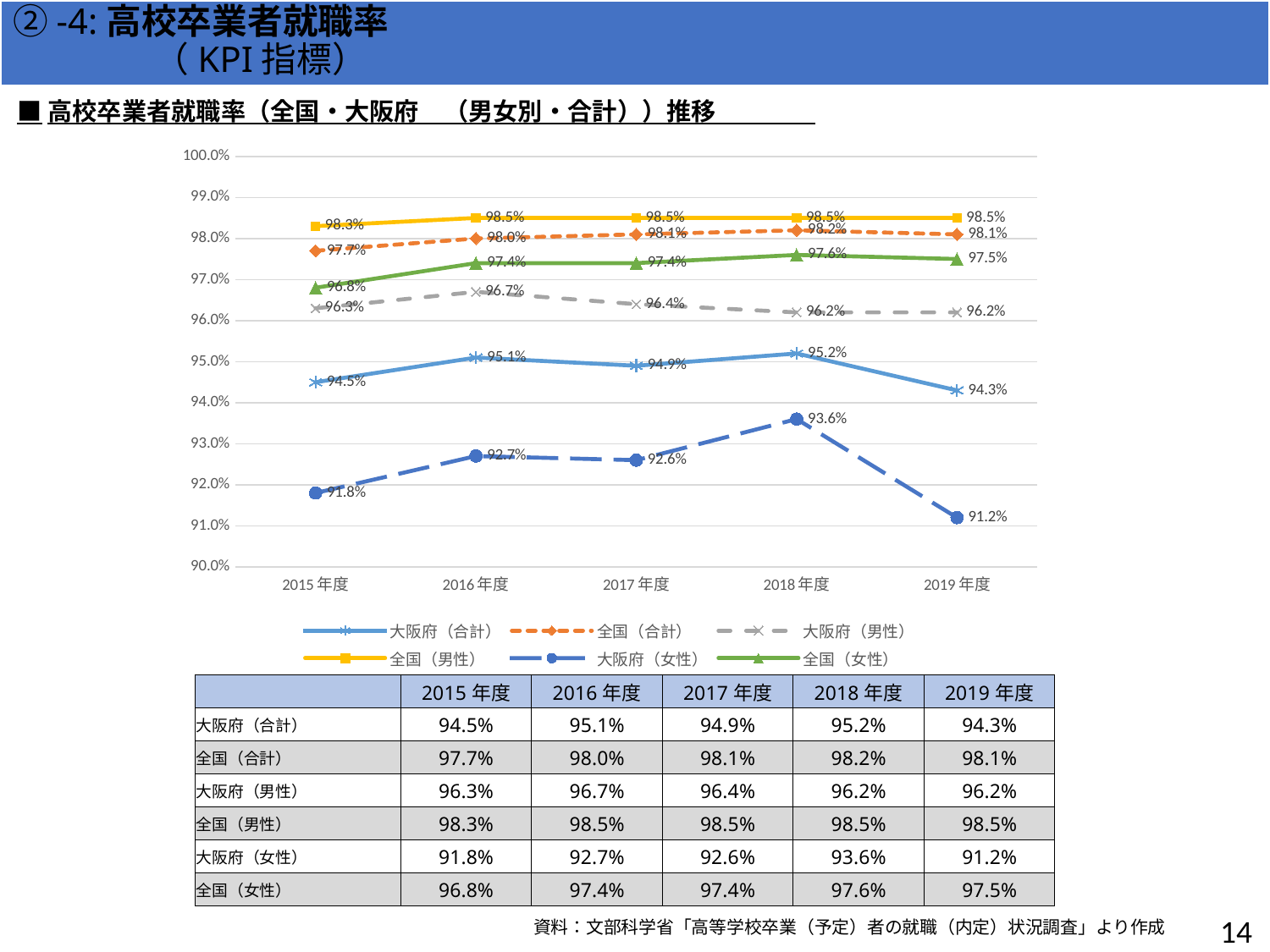
What kind of chart is shown? Line chart Which year has the highest value for 大阪府（合計）? 2018年度 What is the value for 大阪府（合計） in 2019年度? 94.3% How many series does the legend list? 6 Which series is drawn with a yellow line? 全国（男性） What is the difference between 全国（合計） and 大阪府（合計） in 2019年度? 3.8% Which year has the lowest value for 大阪府（女性）? 2019年度 How many years are plotted on the x axis? 5 Which is larger in 2016年度: 大阪府（男性） or 全国（女性）? 全国（女性） What is the value for 全国（男性） in 2015年度? 98.3% Does the value for 大阪府（女性） rise or fall from 2018年度 to 2019年度? Fall What is the value for 大阪府（女性） in 2018年度? 93.6%